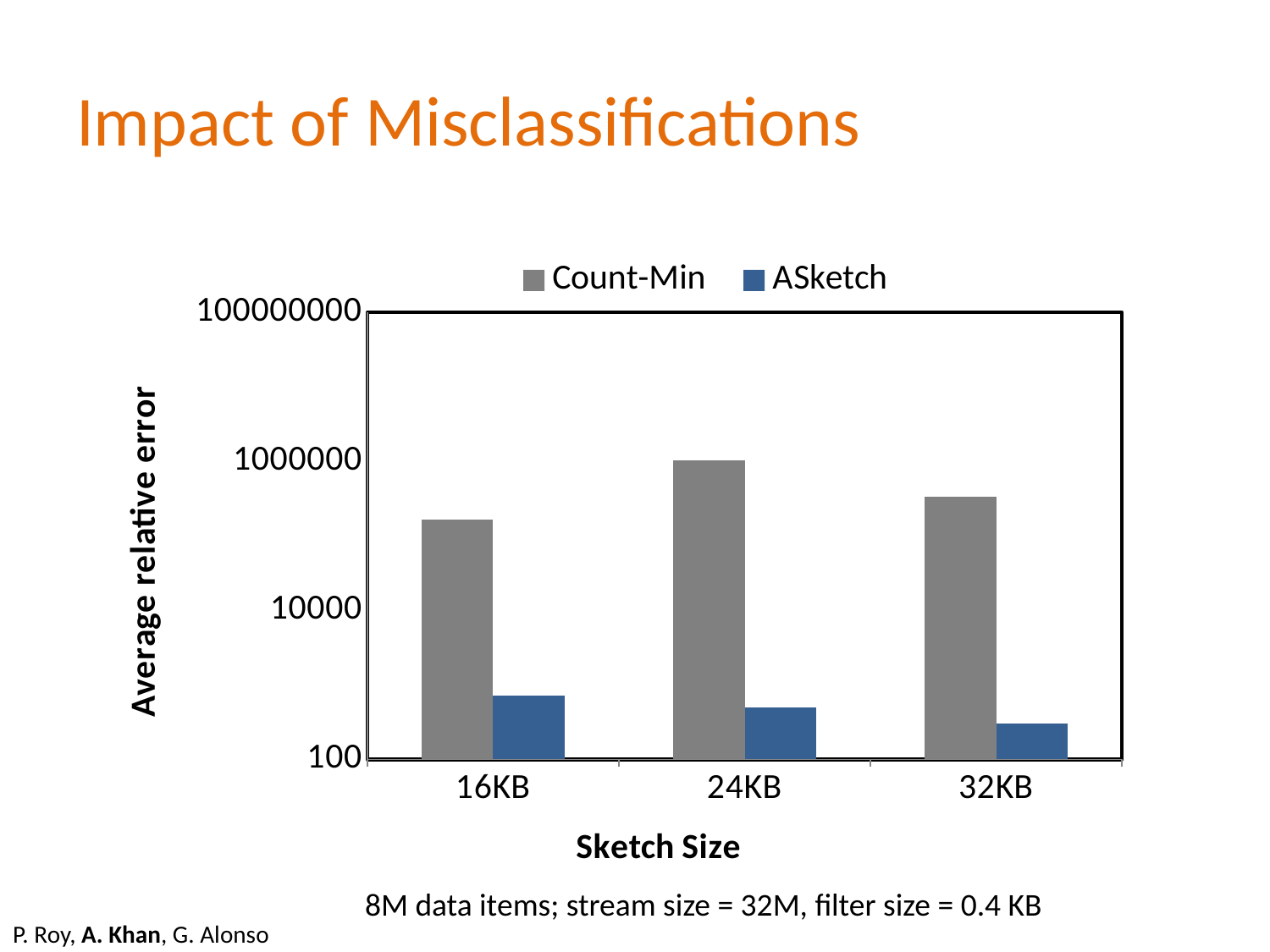
At 24KB, which series has the larger average relative error, Count-Min or ASketch? Count-Min How many series does the legend list? 2 At which sketch size is the ASketch average relative error lowest? 32KB What is the label of the y axis? Average relative error At which sketch size is the Count-Min average relative error highest? 24KB Is the Count-Min value for 16KB greater or less than 10000? greater What kind of chart is shown on the slide? bar chart Is the ASketch value for 16KB greater or less than 10000? less Do the ASketch values rise or fall as the sketch size increases from 16KB to 32KB? fall Which series is shown in gray in the legend? Count-Min At which sketch size is the ASketch average relative error highest? 16KB How many sketch sizes are shown on the x axis? 3